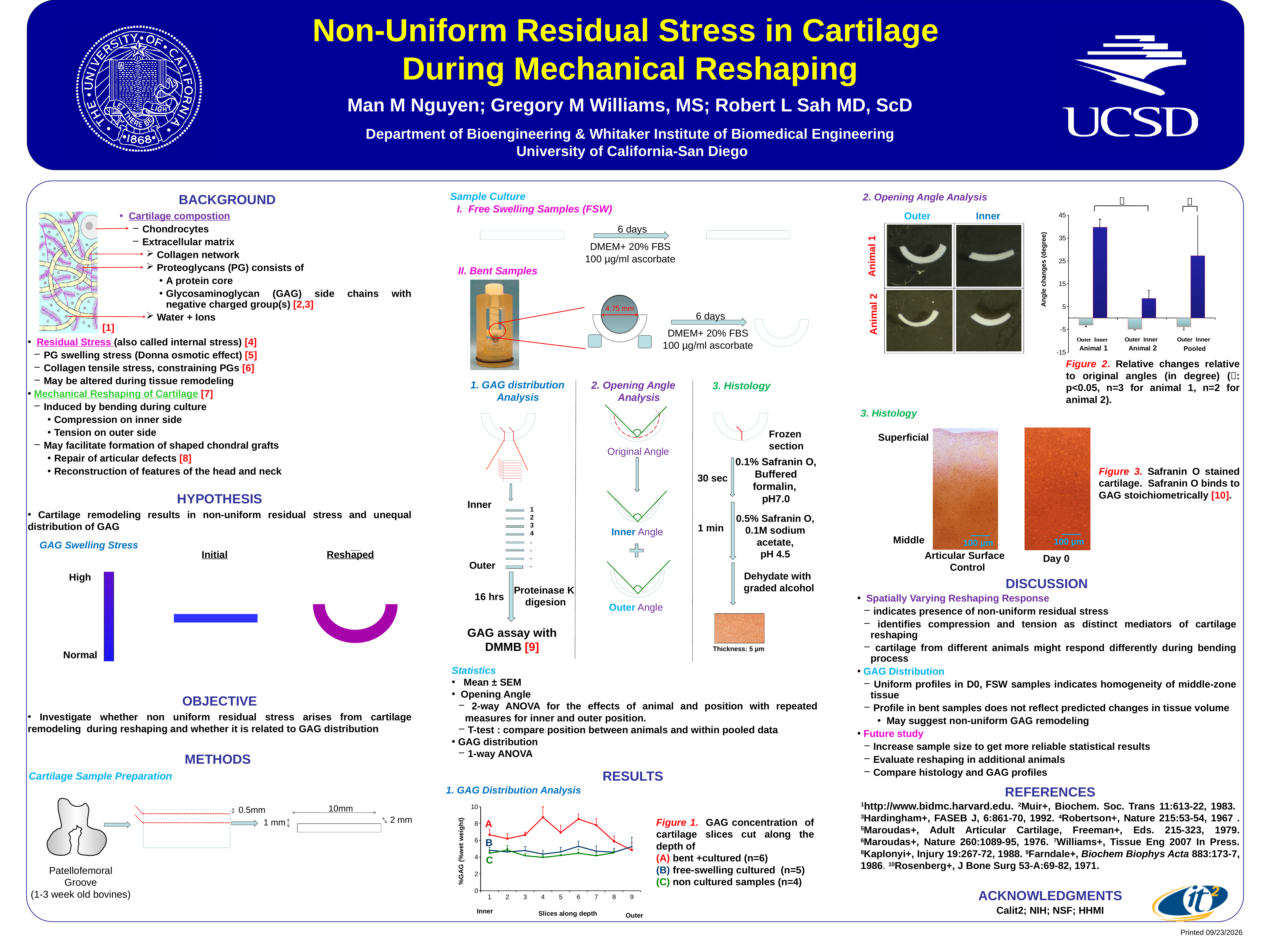
In the GAG Distribution Analysis chart (Figure 1), how many slice positions are plotted along the x axis? 9 In the Opening Angle Analysis chart (Figure 2), what kind of chart is used? bar chart In the Opening Angle Analysis chart (Figure 2), which bar is the highest? Inner, Animal 1 In the Opening Angle Analysis chart (Figure 2), is the Inner value for Animal 2 greater or less than 15? less In the Opening Angle Analysis chart (Figure 2), which is larger: the Inner value for Animal 1 or the Inner value for Animal 2? Inner value for Animal 1 In the GAG Distribution Analysis chart (Figure 1), how many series are plotted? 3 In the Opening Angle Analysis chart (Figure 2), is the Inner value for Animal 1 greater or less than 35? greater In the Opening Angle Analysis chart (Figure 2), what is the y-axis label? Angle changes (degree) In the GAG Distribution Analysis chart (Figure 1), what kind of chart is used? line chart In the Opening Angle Analysis chart (Figure 2), which is larger: the Inner value for Pooled or the Inner value for Animal 2? Inner value for Pooled In the GAG Distribution Analysis chart (Figure 1), which series has the highest value at slice 4? A In the GAG Distribution Analysis chart (Figure 1), is the value of series A at slice 4 greater or less than 8? greater